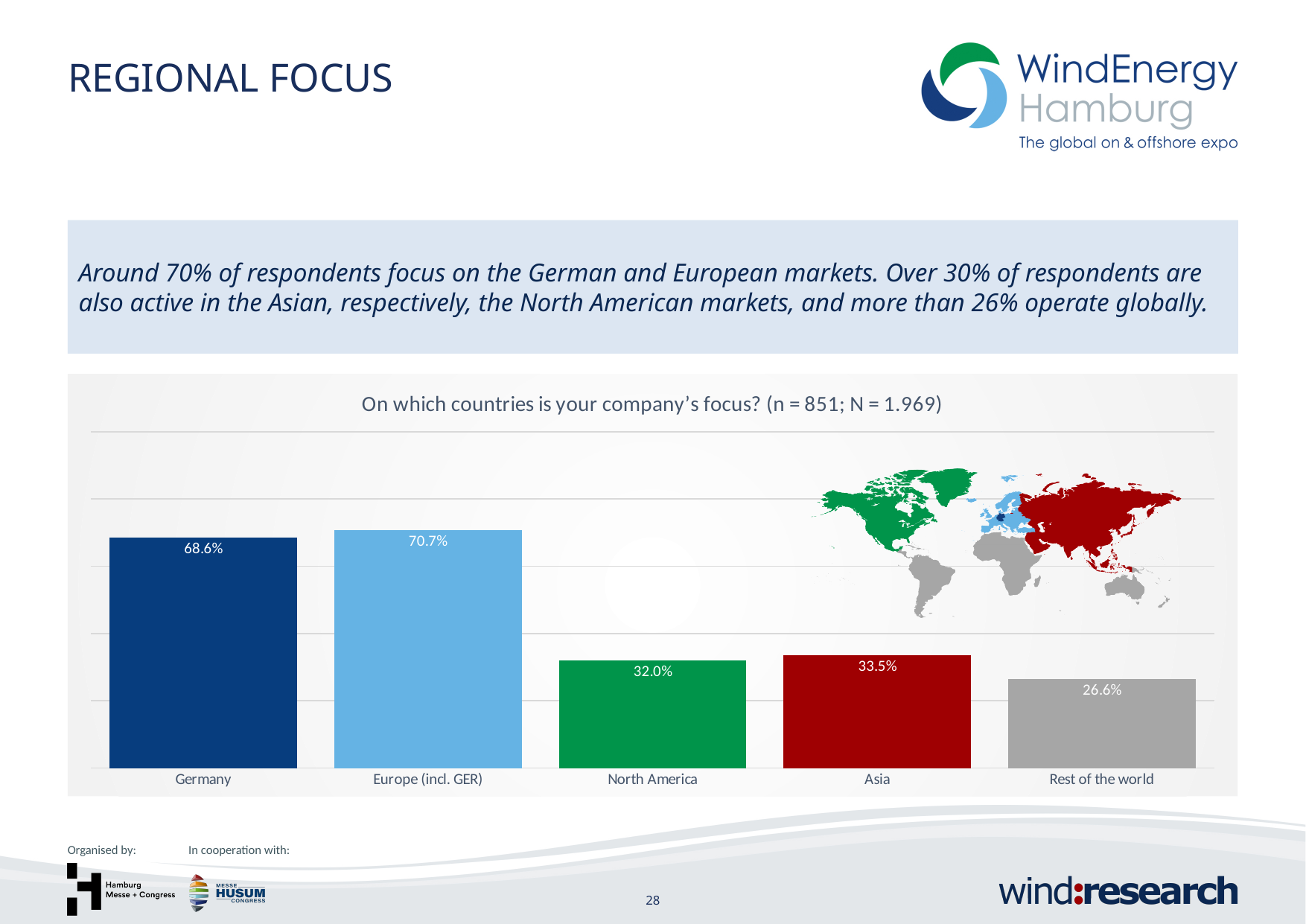
What kind of chart is shown on the slide? Bar chart What is the value for Europe (incl. GER)? 70.7% Which is larger, the value for Germany or the value for Asia? Germany What is the value for North America? 32.0% What is the difference between the values for Asia and North America? 1.5% Which category has the lowest value? Rest of the world Which category has the highest value? Europe (incl. GER) What is the value for Germany? 68.6% What is the value for Asia? 33.5% How many categories are shown in the chart? 5 What is the value for Rest of the world? 26.6% What is the difference between the values for Europe (incl. GER) and Germany? 2.1%